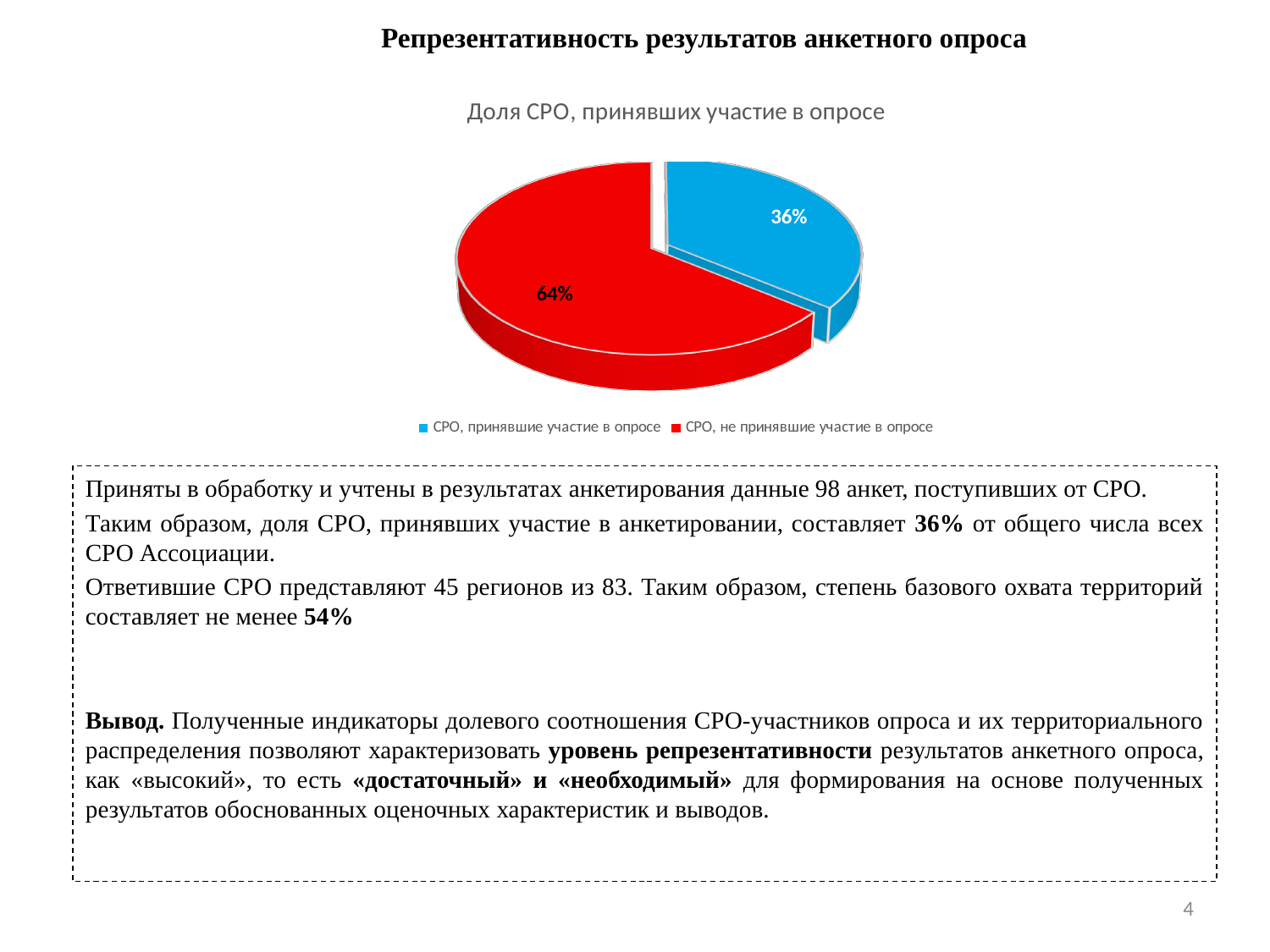
Which slice of the pie is the largest? СРО, не принявшие участие в опросе Which slice of the pie is the smallest? СРО, принявшие участие в опросе How many entries does the legend list? 2 What kind of chart is shown on the slide? pie chart What is the chart's title? Доля СРО, принявших участие в опросе What colour is the slice for 'СРО, не принявшие участие в опросе'? red How many slices does the pie chart have? 2 What is the difference in percentage points between the two slices of the pie? 28 What share of the pie is labelled for 'СРО, принявшие участие в опросе'? 36% What share of the pie is labelled for 'СРО, не принявшие участие в опросе'? 64% Which is larger: the share of 'СРО, принявшие участие в опросе' or 'СРО, не принявшие участие в опросе'? СРО, не принявшие участие в опросе